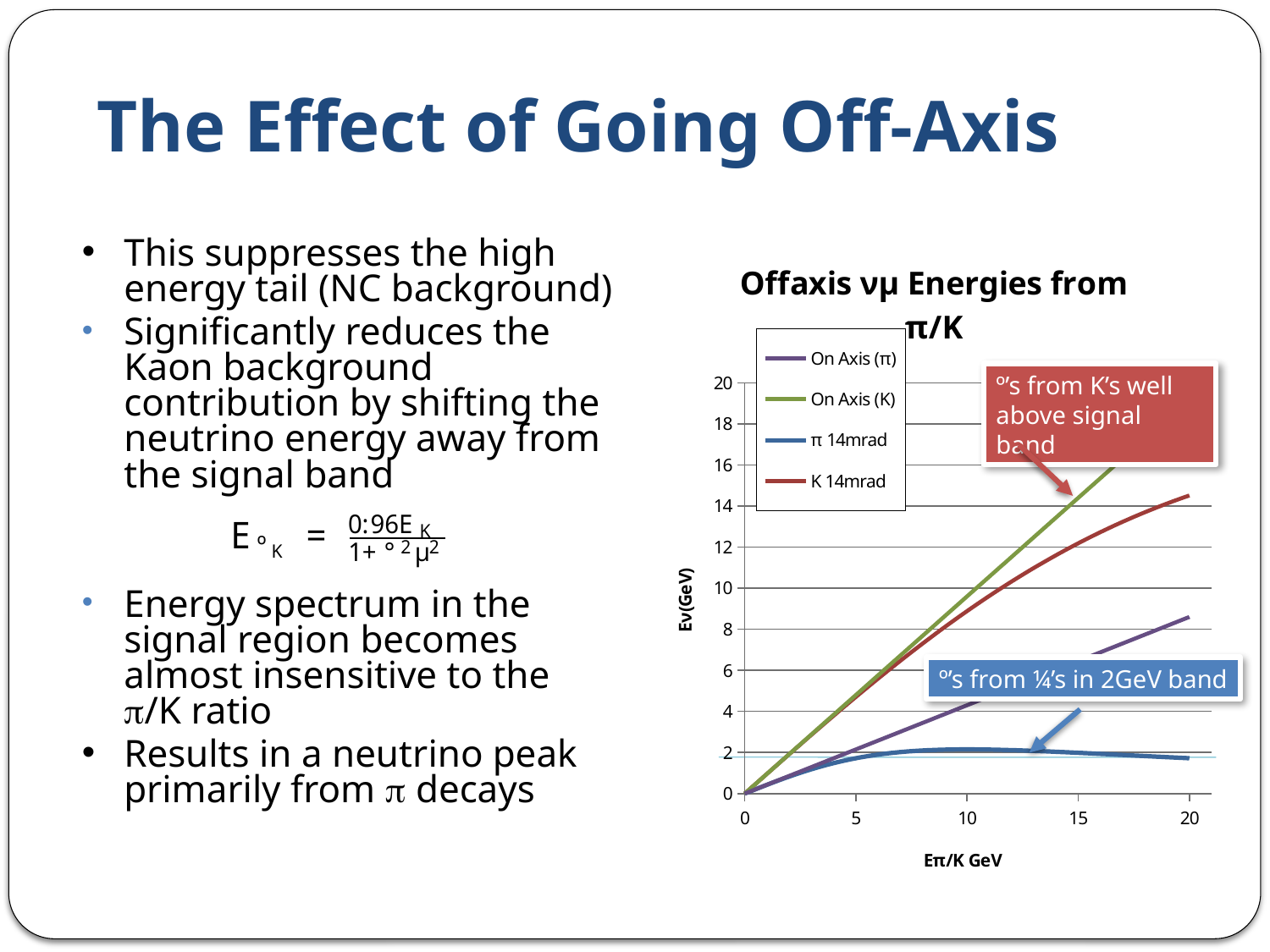
What kind of chart is shown on the slide? line chart Is the value of the π 14mrad series at Eπ/K = 20 GeV greater or less than 4? less Is the value of the On Axis (π) series at Eπ/K = 20 GeV greater or less than 6? greater What is the label of the chart's x axis? Eπ/K GeV Which series reaches the highest Eν value on the chart? On Axis (K) Is the value of the K 14mrad series at Eπ/K = 20 GeV greater or less than 10? greater At Eπ/K = 10 GeV, which series is larger: On Axis (K) or On Axis (π)? On Axis (K) At Eπ/K = 20 GeV, which series is larger: K 14mrad or π 14mrad? K 14mrad Which series has the lowest value at Eπ/K = 20 GeV? π 14mrad What is the title of the chart? Offaxis νμ Energies from π/K How many series does the chart legend list? 4 Does the K 14mrad series rise or fall as Eπ/K increases from 0 to 20 GeV? rise